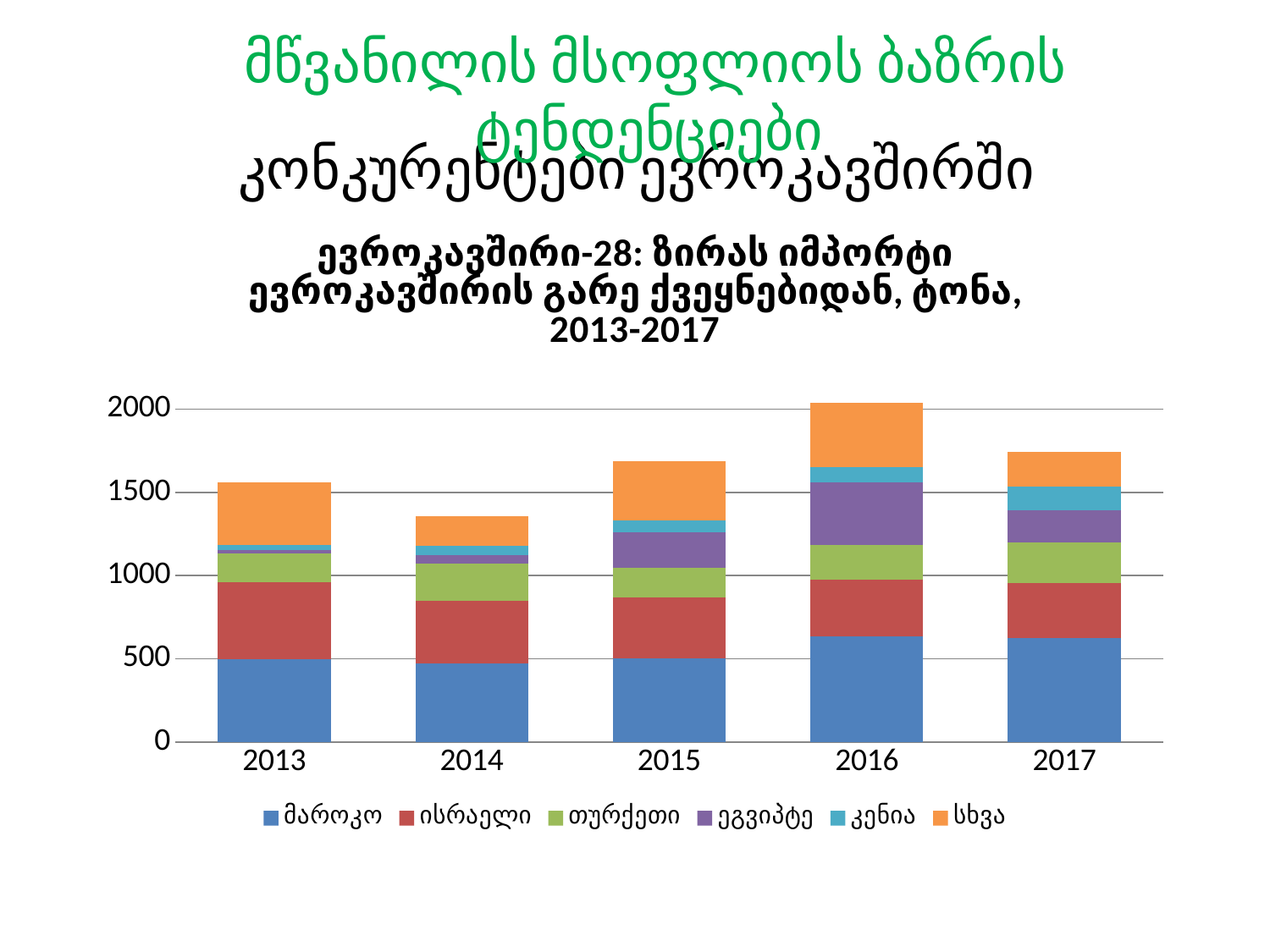
Which series is listed first in the chart legend? მაროკო How many series does the chart legend list? 6 Is the value for მაროკო in 2016 greater or less than 500? greater Which year has the lowest total stacked bar? 2014 Is the total stacked bar for 2016 greater or less than 2000? greater Do the total stacked bars rise or fall from 2014 to 2016? rise Is the total stacked bar for 2015 greater or less than 1500? greater Which year has the highest total stacked bar? 2016 What kind of chart is shown on the slide? stacked bar chart Which year has the larger total stacked bar, 2013 or 2014? 2013 How many years (categories) are shown on the x axis of the chart? 5